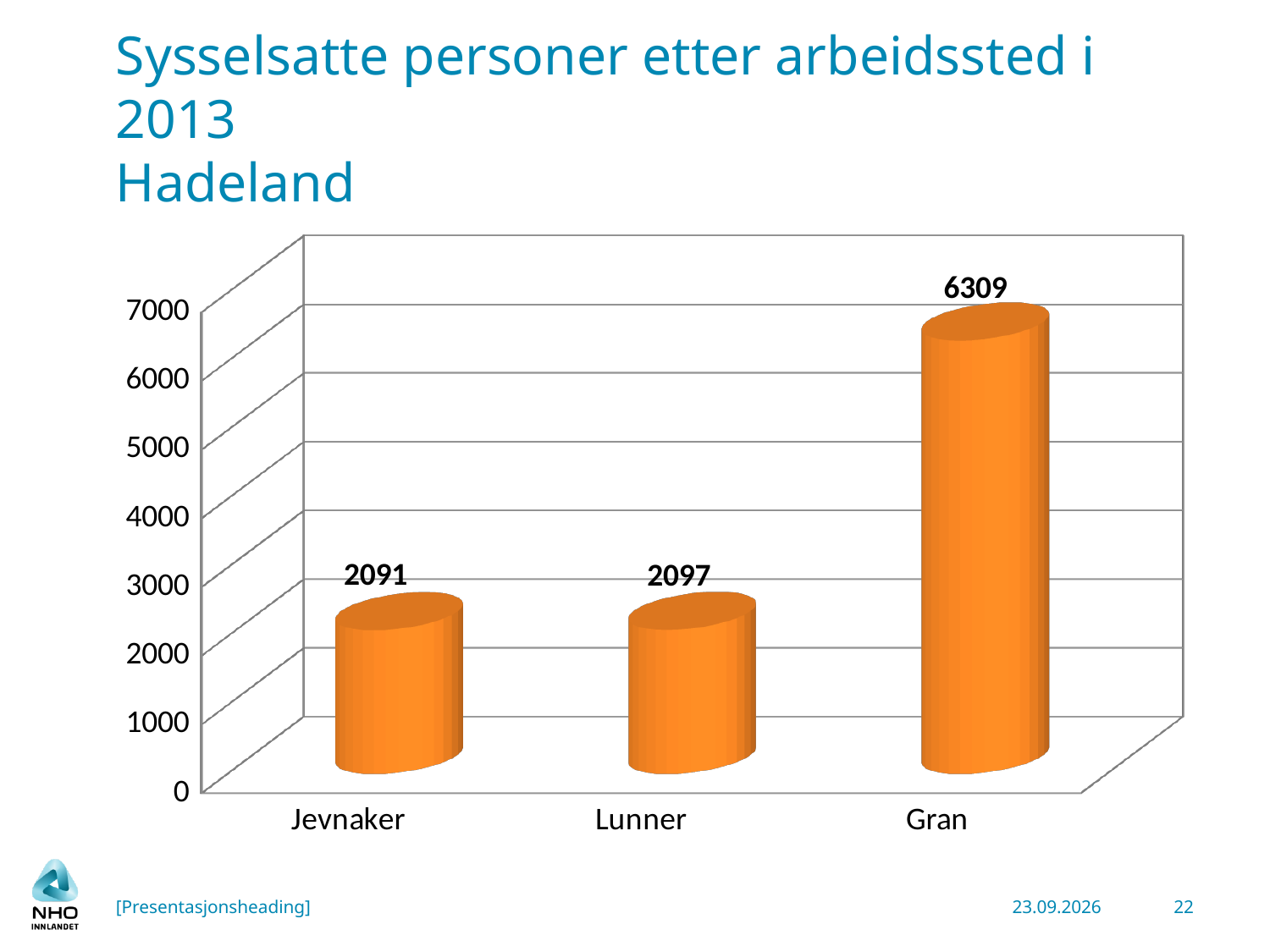
What is the value for Gran? 6309 What is the value for Lunner? 2097 How many categories are shown on the x axis? 3 What kind of chart is shown on the slide? Bar chart What is the difference between the values for Gran and Lunner? 4212 What is the value for Jevnaker? 2091 What is the title of the slide? Sysselsatte personer etter arbeidssted i 2013 Hadeland Which category has the highest value? Gran What is the difference between the values for Gran and Jevnaker? 4218 Which is larger, the value for Gran or the value for Lunner? Gran Is the value for Gran greater or less than 6000? greater Is the value for Jevnaker greater or less than 3000? less